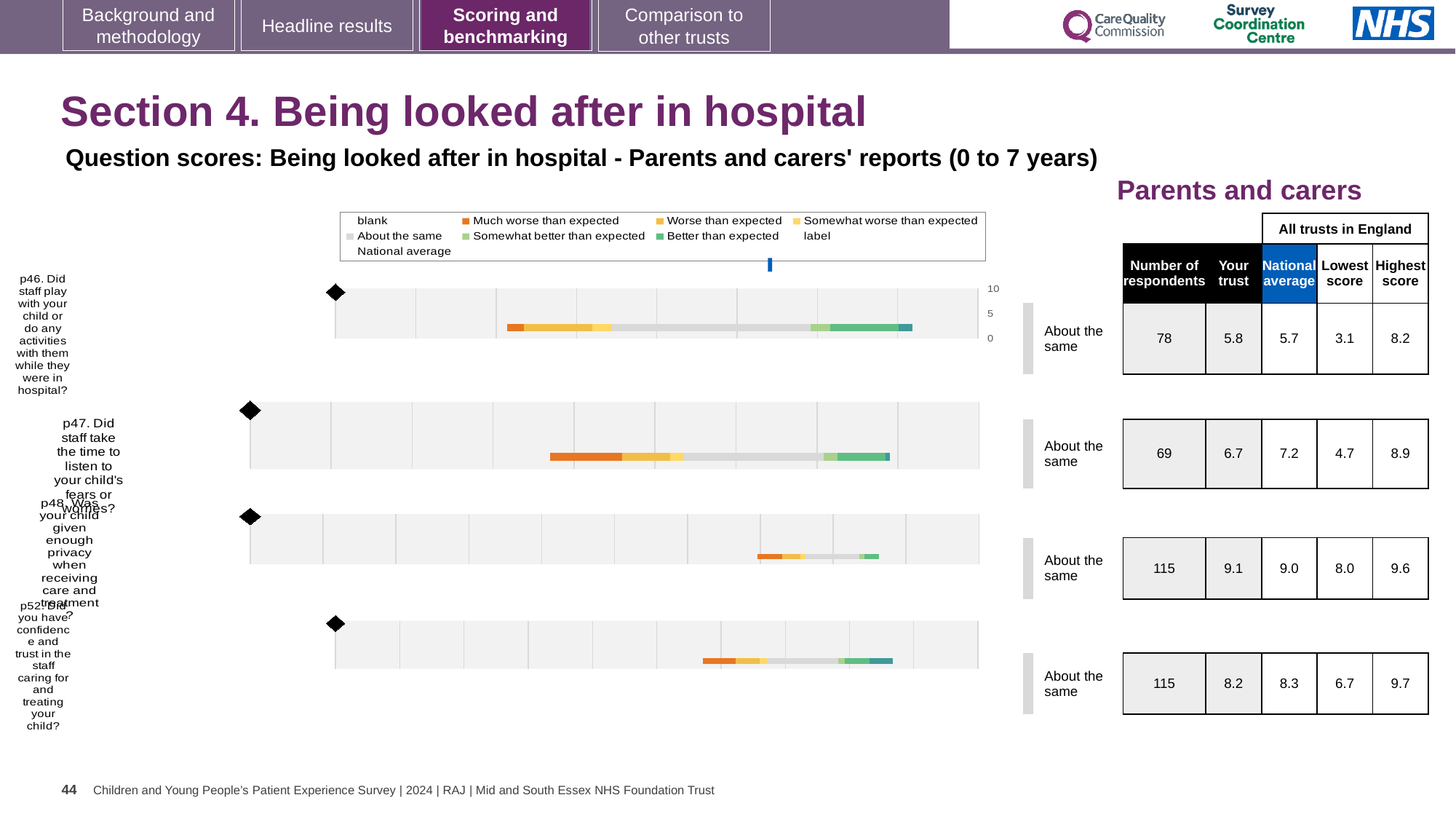
How many question charts are shown on the slide? 4 In the legend, what colour represents 'Much worse than expected'? orange For the p52 chart (Did you have confidence and trust in the staff caring for and treating your child?), what is the lowest score across all trusts in England? 6.7 Which question chart has the lowest 'Your trust' score? p46 For the p47 chart (Did staff take the time to listen to your child's fears or worries?), what is the national average score? 7.2 For the p47 chart, which is larger: the 'Your trust' score or the national average? National average For the p46 chart, what is the difference between the highest score and the lowest score across all trusts in England? 5.1 What kind of chart is used to show the question scores on this slide? bar chart Which question chart has the highest 'Your trust' score? p48 What benchmark category is shown next to the p52 chart? About the same For the p48 chart (Was your child given enough privacy when receiving care and treatment?), how many respondents are there? 115 For the p46 chart (Did staff play with your child or do any activities with them while they were in hospital?), what is the 'Your trust' score? 5.8